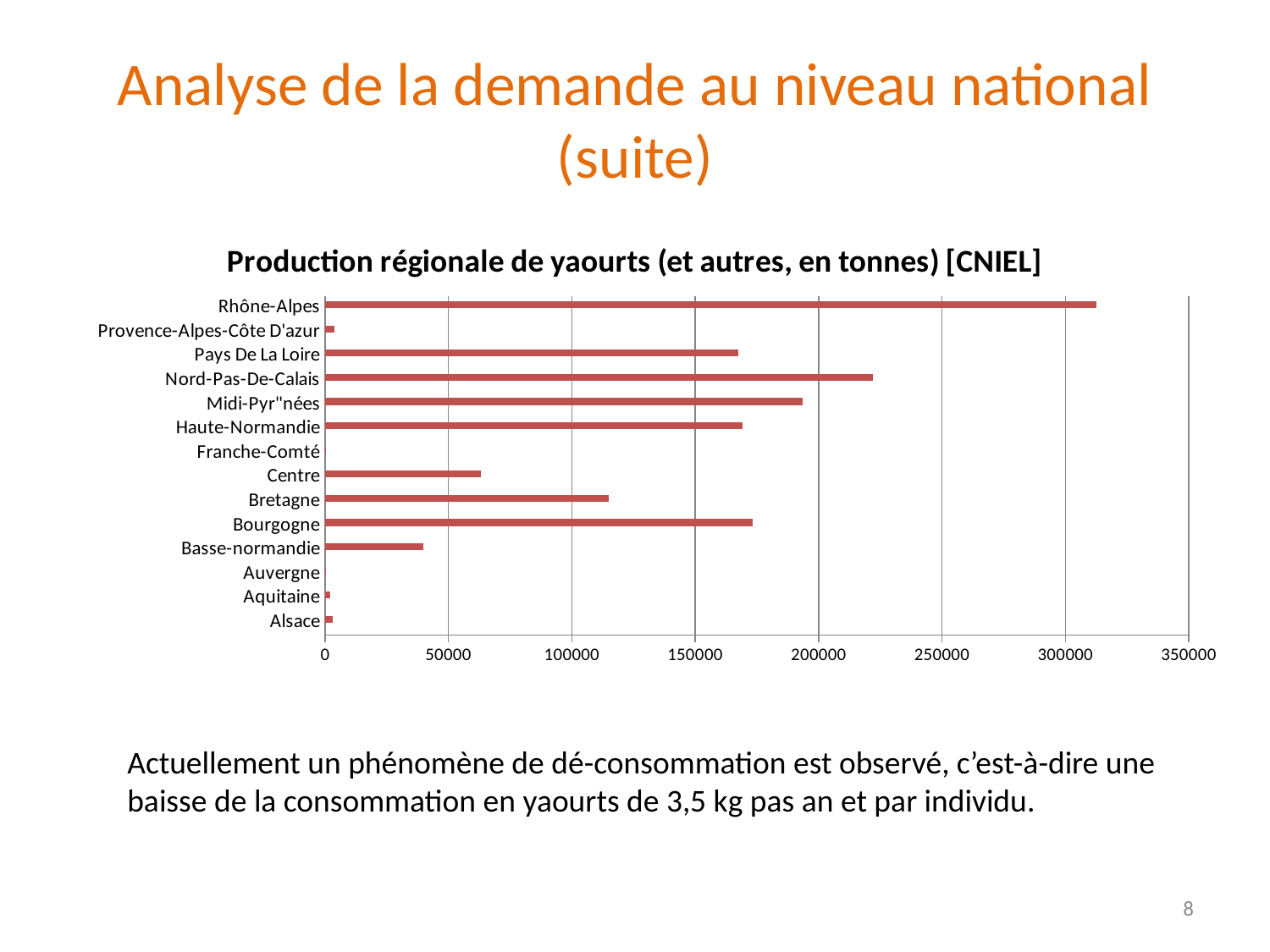
Is the value for Midi-Pyrénées greater or less than 200000? less Which region has the larger production, Bretagne or Centre? Bretagne How many regions are listed on the chart? 14 Is the value for Bourgogne greater or less than 150000? greater Which region has the highest production of yaourts on the chart? Rhône-Alpes Which region has the larger production, Nord-Pas-De-Calais or Midi-Pyrénées? Nord-Pas-De-Calais Is the value for Basse-normandie greater or less than 50000? less What is the title of the chart? Production régionale de yaourts (et autres, en tonnes) [CNIEL] What kind of chart is shown on the slide? Bar chart